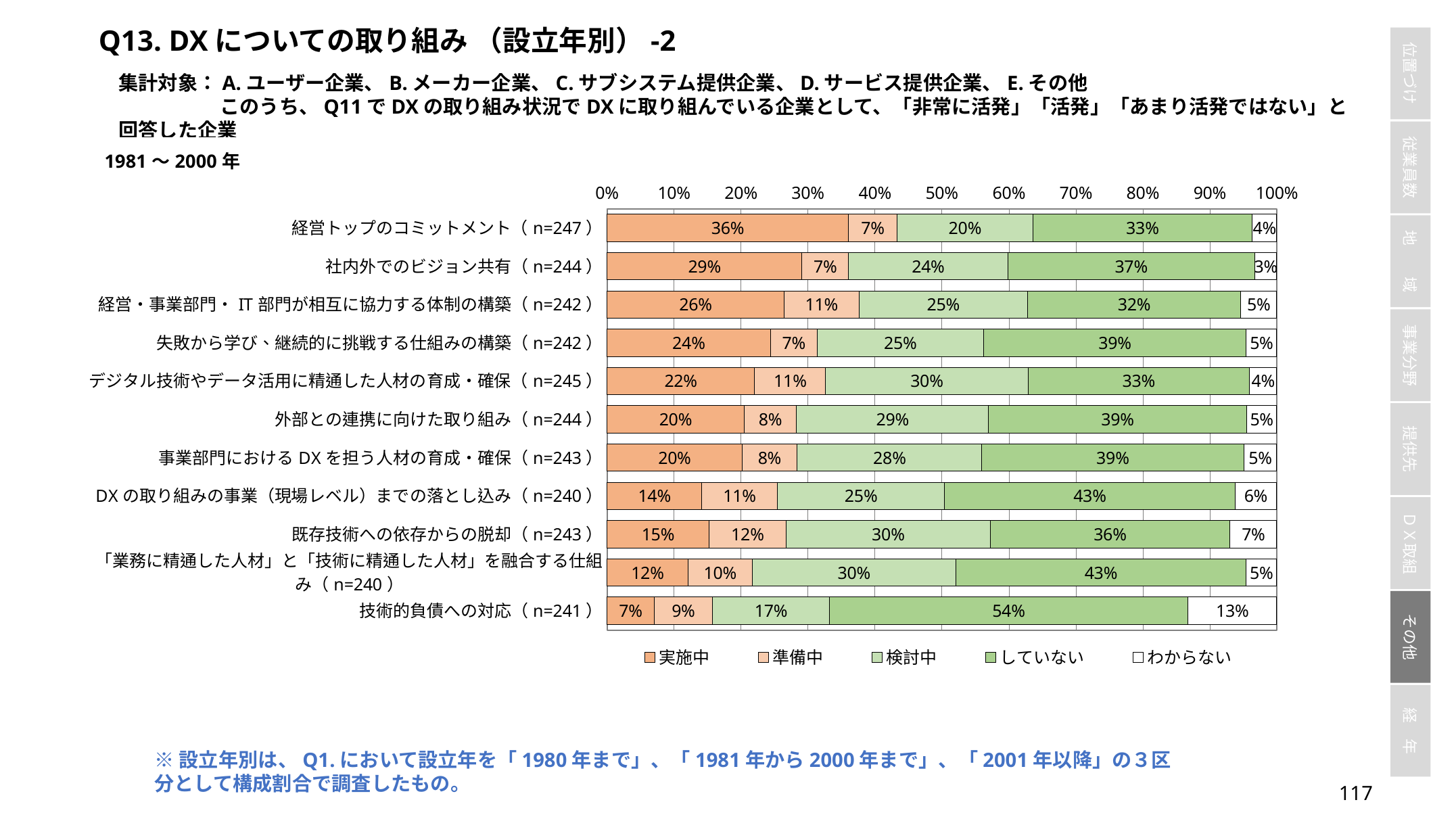
What is the sample size (n) shown for 経営トップのコミットメント? n=247 What is the 実施中 value for 経営トップのコミットメント? 36% How many categories (initiatives) are plotted in the chart? 11 How many series does the legend list? 5 What type of chart is shown on the slide? Stacked bar chart What is the していない value for 技術的負債への対応? 54% Which category has the highest 実施中 value? 経営トップのコミットメント Which is larger: the していない value for 既存技術への依存からの脱却 or for DXの取り組みの事業（現場レベル）までの落とし込み? DXの取り組みの事業（現場レベル）までの落とし込み What is the 検討中 value for デジタル技術やデータ活用に精通した人材の育成・確保? 30% What is the difference between the 実施中 values for 経営トップのコミットメント and 社内外でのビジョン共有? 7% Which category has the highest わからない value? 技術的負債への対応 Which category has the lowest 実施中 value? 技術的負債への対応